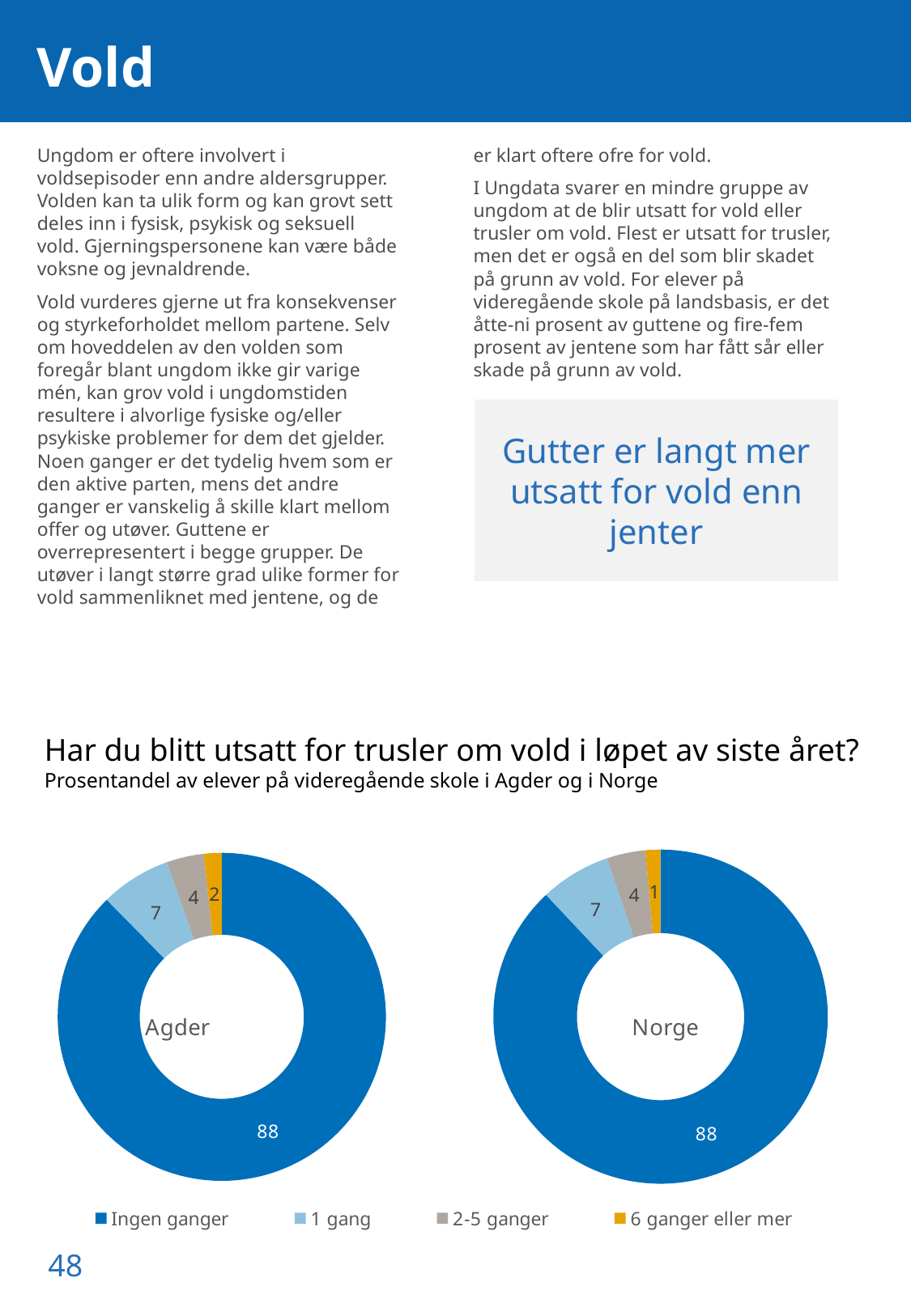
In the Norge chart, which category has the largest share? Ingen ganger In the Agder chart, which category has the smallest share? 6 ganger eller mer In the Agder chart, what is the value for '6 ganger eller mer'? 2 In the Agder chart, what is the value for '2-5 ganger'? 4 What is the title of the chart section on the slide? Har du blitt utsatt for trusler om vold i løpet av siste året? In the Norge chart, what is the value for '1 gang'? 7 In the Agder chart, what is the value for 'Ingen ganger'? 88 What kind of chart is used to show the Agder and Norge data? Donut (pie) chart In the Norge chart, what is the value for '6 ganger eller mer'? 1 In the Agder chart, which is larger: '1 gang' or '2-5 ganger'? 1 gang What is the difference between the '6 ganger eller mer' value in the Agder chart and in the Norge chart? 1 How many categories does the legend list for the charts? 4